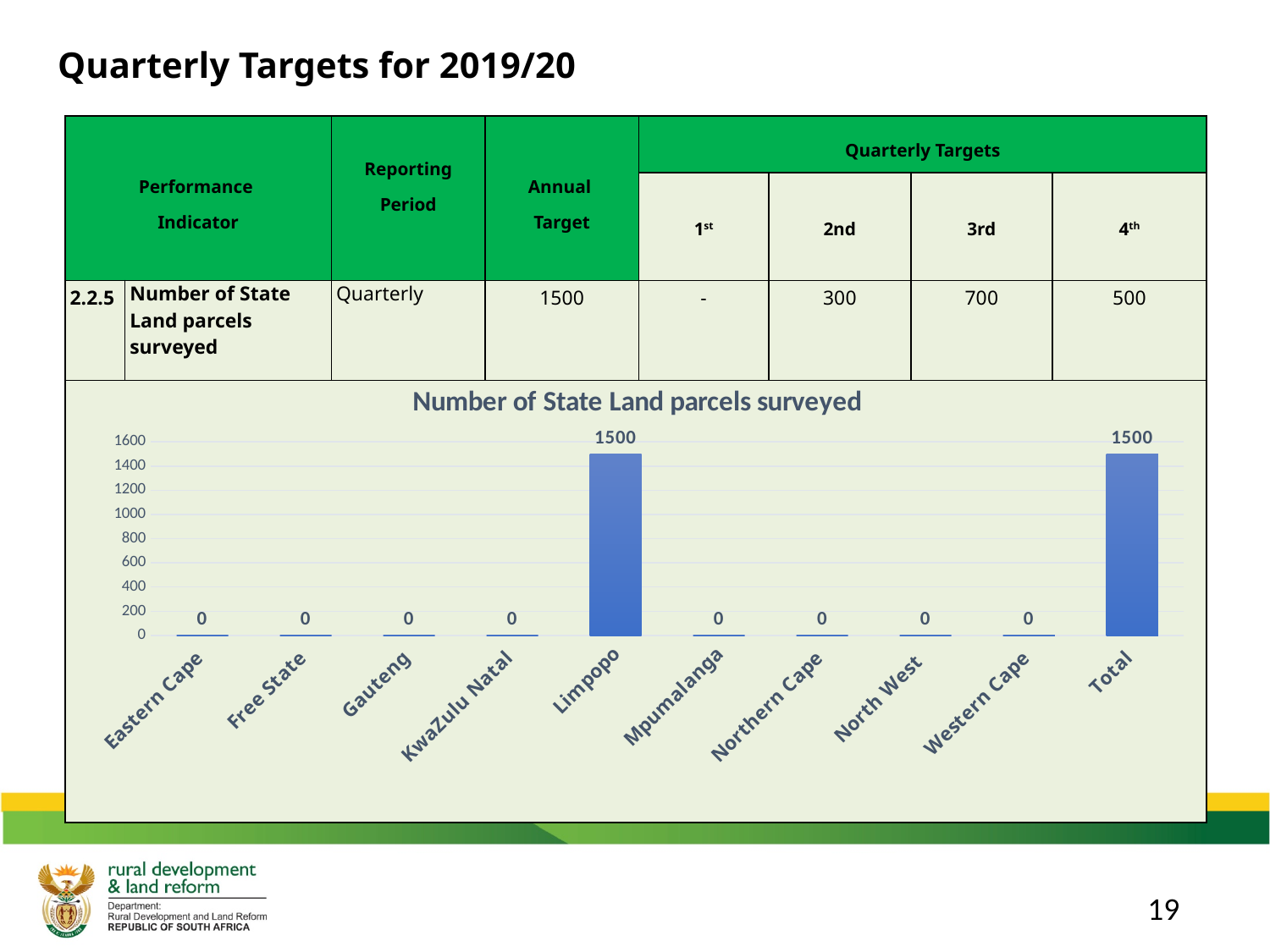
How many categories are shown on the x axis of the chart? 10 How many provinces in the chart have a value of 0? 8 Which province has the highest number of State Land parcels surveyed? Limpopo What is the title of the chart? Number of State Land parcels surveyed Which is larger, the value for Limpopo or the value for Western Cape? Limpopo Is the value for Limpopo greater or less than 1000? greater What is the highest value shown on the y axis of the chart? 1600 What is the value for Total in the chart? 1500 What kind of chart is shown on the slide? bar chart What is the difference between the values for Limpopo and Mpumalanga? 1500 What is the value for Gauteng in the chart? 0 What is the value for Limpopo in the chart? 1500